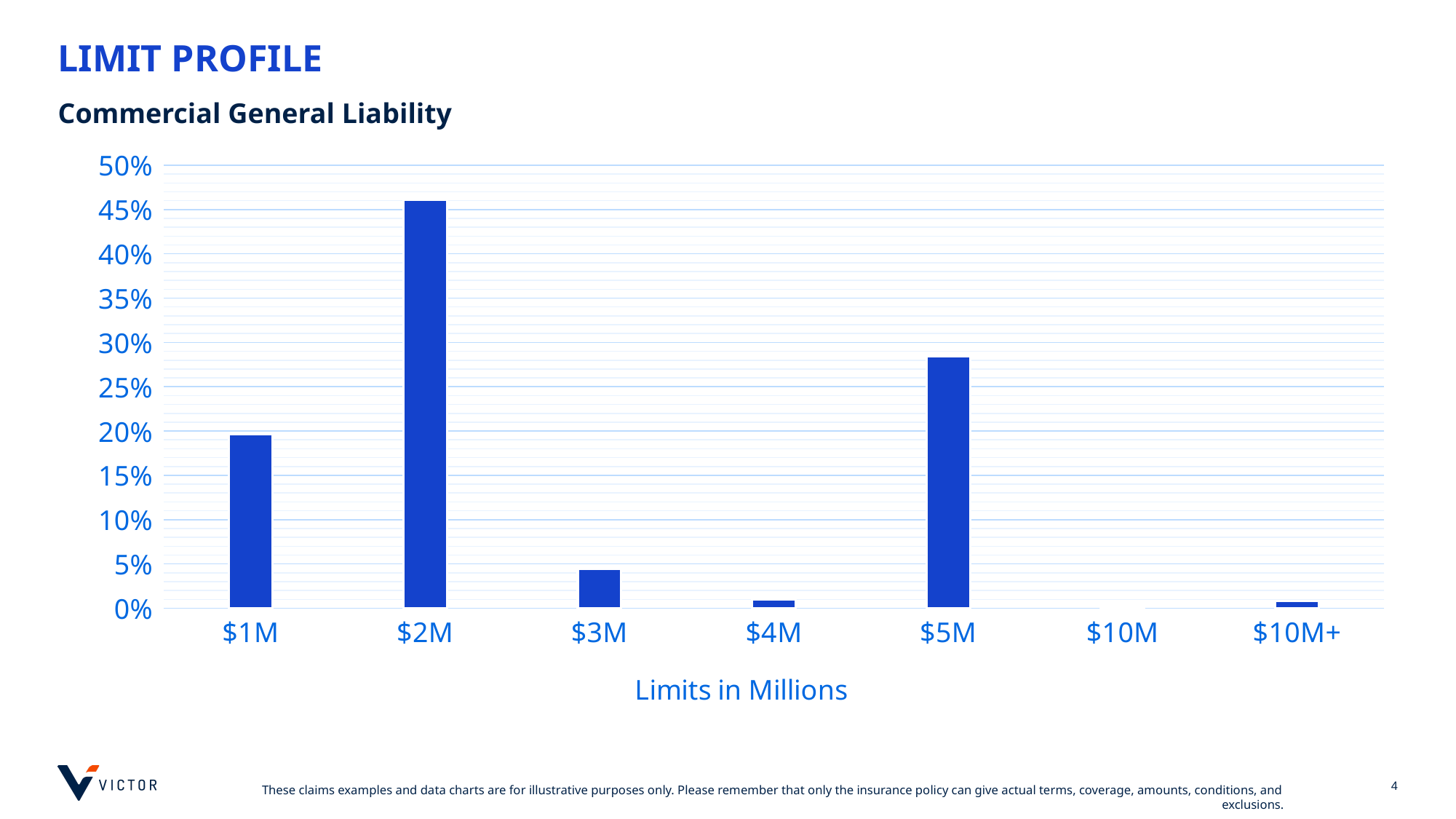
Which limit category has the highest share? $2M How many limit categories are shown on the x axis? 7 Is the value for $4M greater or less than 5%? less Is the value for $2M greater or less than 40%? greater Is the value for $3M greater or less than 5%? less What is the x-axis title of the chart? Limits in Millions Which is larger, the value for $3M or the value for $4M? $3M What kind of chart is shown on the slide? bar chart Which limit category has the lowest share? $10M Which is larger, the value for $1M or the value for $5M? $5M